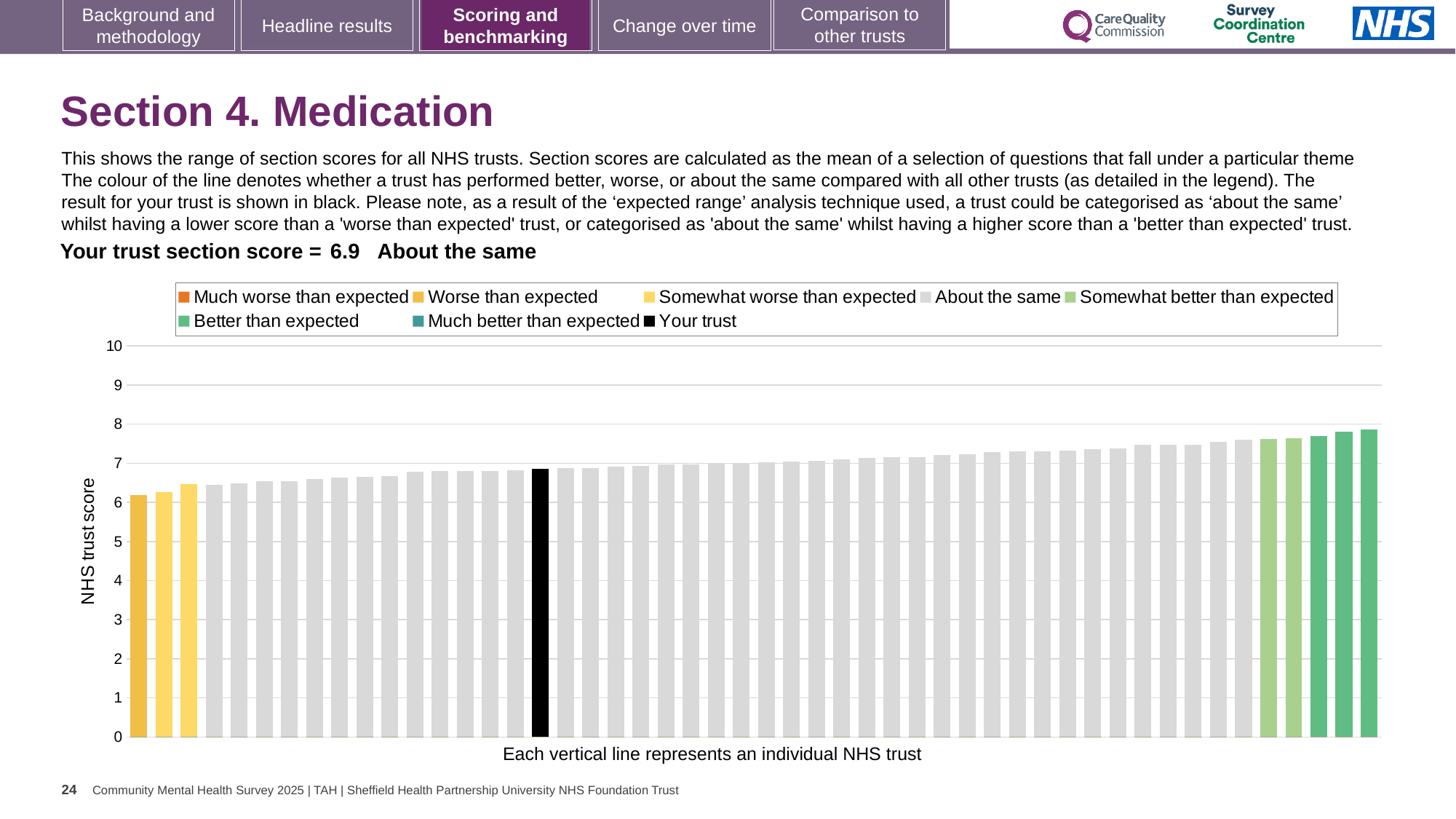
Is the value for the highest-scoring trust greater or less than 8? less Which legend entry is shown in black? Your trust Is the value for the highest-scoring trust greater or less than 7? greater What is the label on the vertical axis of the chart? NHS trust score Is the value for the lowest-scoring trust greater or less than 6? greater How many entries does the chart legend list? 8 What kind of chart is used to show the section scores for all NHS trusts? bar chart What is the section score for your trust shown on the chart? 6.9 How is your trust's section score categorised compared with other trusts? About the same Do the trust scores rise or fall from left to right across the chart? rise